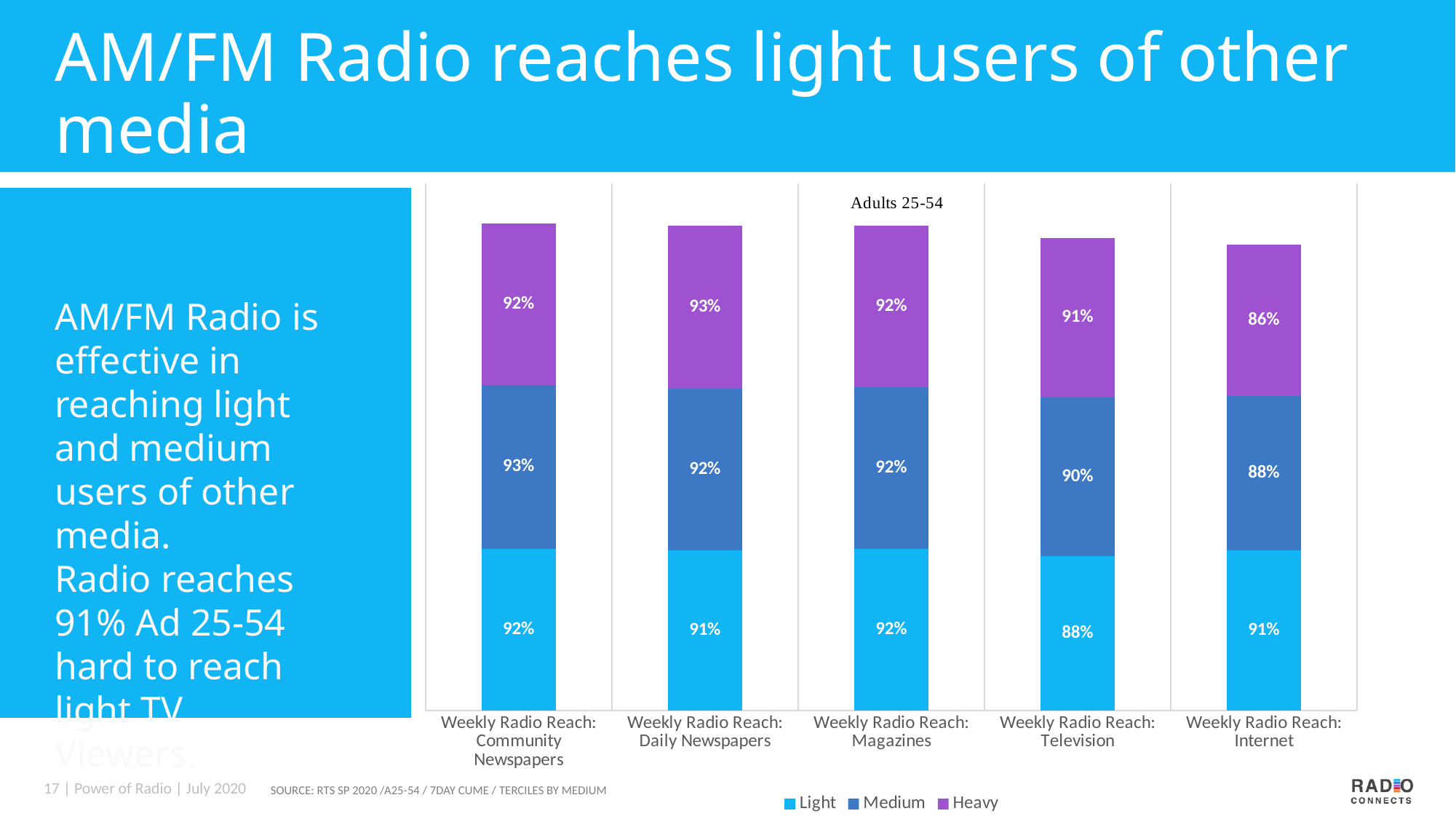
Which category has the lowest Light value? Weekly Radio Reach: Television What is the Medium value for Weekly Radio Reach: Daily Newspapers? 92% Which category has the highest Heavy value? Weekly Radio Reach: Daily Newspapers How many categories are shown on the x axis? 5 Which category has the lowest Heavy value? Weekly Radio Reach: Internet What type of chart is shown on the slide? stacked bar chart Which is larger: the Light value for Internet or the Heavy value for Internet? Light value for Internet What is the difference between the Medium value for Community Newspapers and the Medium value for Internet? 5% How many series does the legend list? 3 What age group is named in the label above the chart? Adults 25-54 What is the Light value for Weekly Radio Reach: Television? 88% What is the Heavy value for Weekly Radio Reach: Internet? 86%